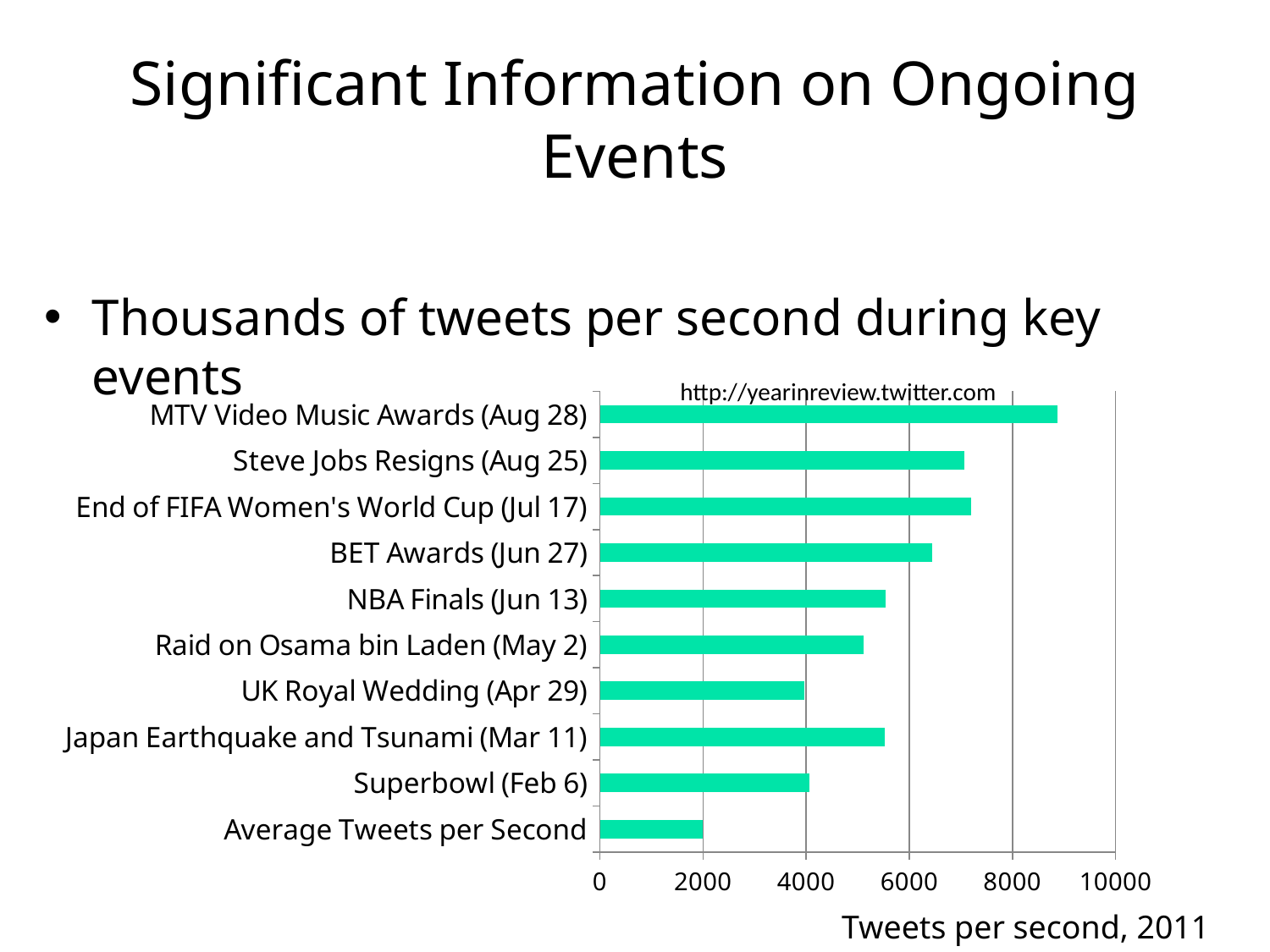
Is the value for UK Royal Wedding (Apr 29) greater or less than 6000? less Which category has the lowest value in the chart? Average Tweets per Second How many categories (bars) does the chart show? 10 Is the value for BET Awards (Jun 27) greater or less than 6000? greater What is the label on the horizontal axis of the chart? Tweets per second, 2011 What source URL is printed above the chart? http://yearinreview.twitter.com Which is larger: the value for MTV Video Music Awards (Aug 28) or for Steve Jobs Resigns (Aug 25)? MTV Video Music Awards (Aug 28) Which is larger: the value for BET Awards (Jun 27) or for UK Royal Wedding (Apr 29)? BET Awards (Jun 27) What kind of chart is shown on the slide? bar chart Which event has the highest number of tweets per second? MTV Video Music Awards (Aug 28) Is the value for MTV Video Music Awards (Aug 28) greater or less than 8000? greater